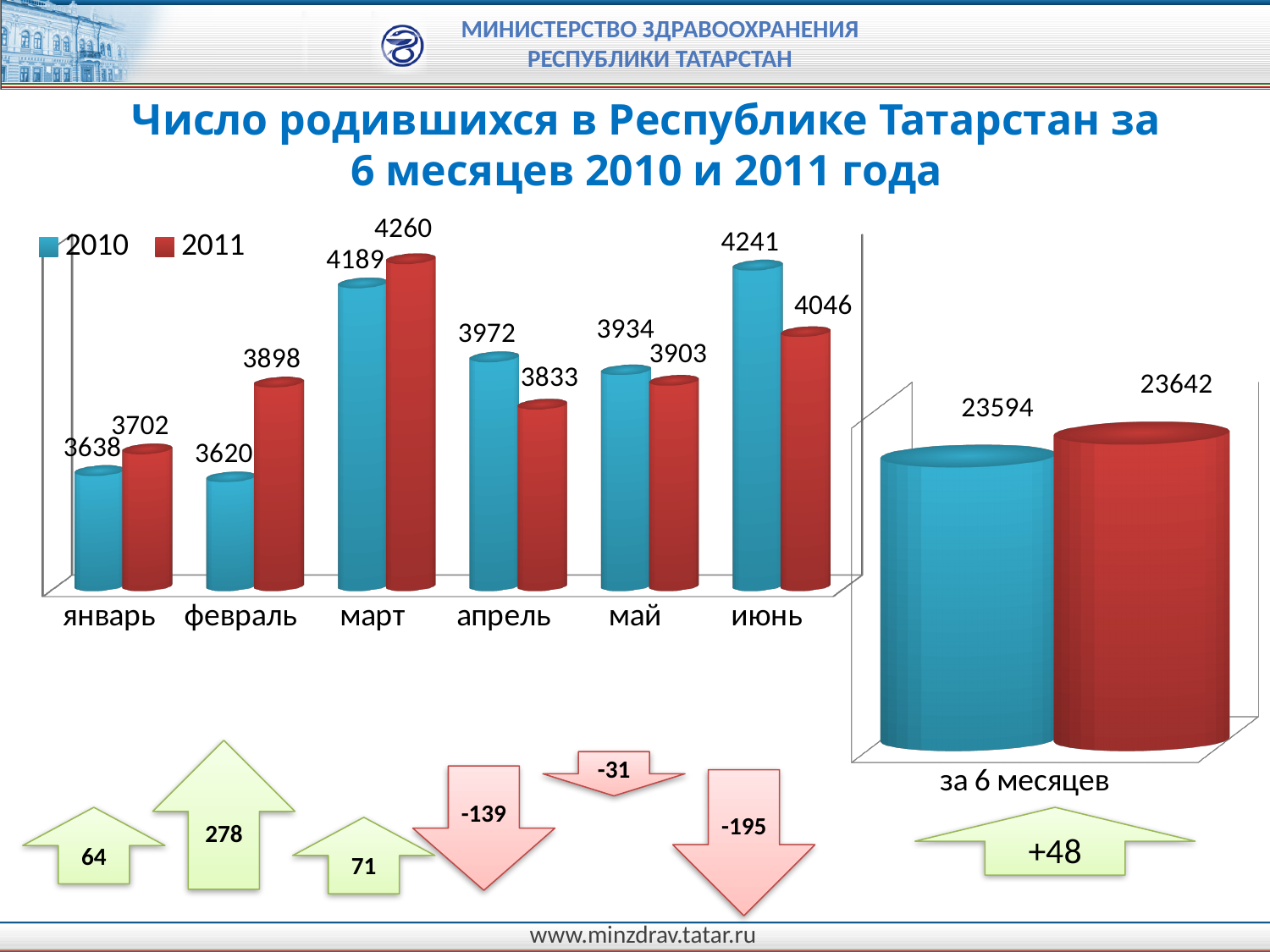
In the monthly chart on the left, what is the value for 2010 in июнь? 4241 In the monthly chart on the left, which month has the lowest value for 2010? февраль In the monthly chart on the left, what is the value for 2011 in февраль? 3898 In the monthly chart on the left, how many months are shown on the x axis? 6 In the monthly chart on the left, which month has the highest value for 2010? июнь In the monthly chart on the left, which is larger in апрель: the 2010 value or the 2011 value? 2010 In the chart on the right labelled 'за 6 месяцев', what is the difference between the 2011 and 2010 values? 48 What kind of chart is the monthly chart on the left? bar chart In the monthly chart on the left, what is the value for 2011 in март? 4260 In the monthly chart on the left, how many series does the legend list? 2 In the chart on the right labelled 'за 6 месяцев', what is the value of the red (2011) bar? 23642 In the monthly chart on the left, what is the difference between the 2011 and 2010 values in февраль? 278